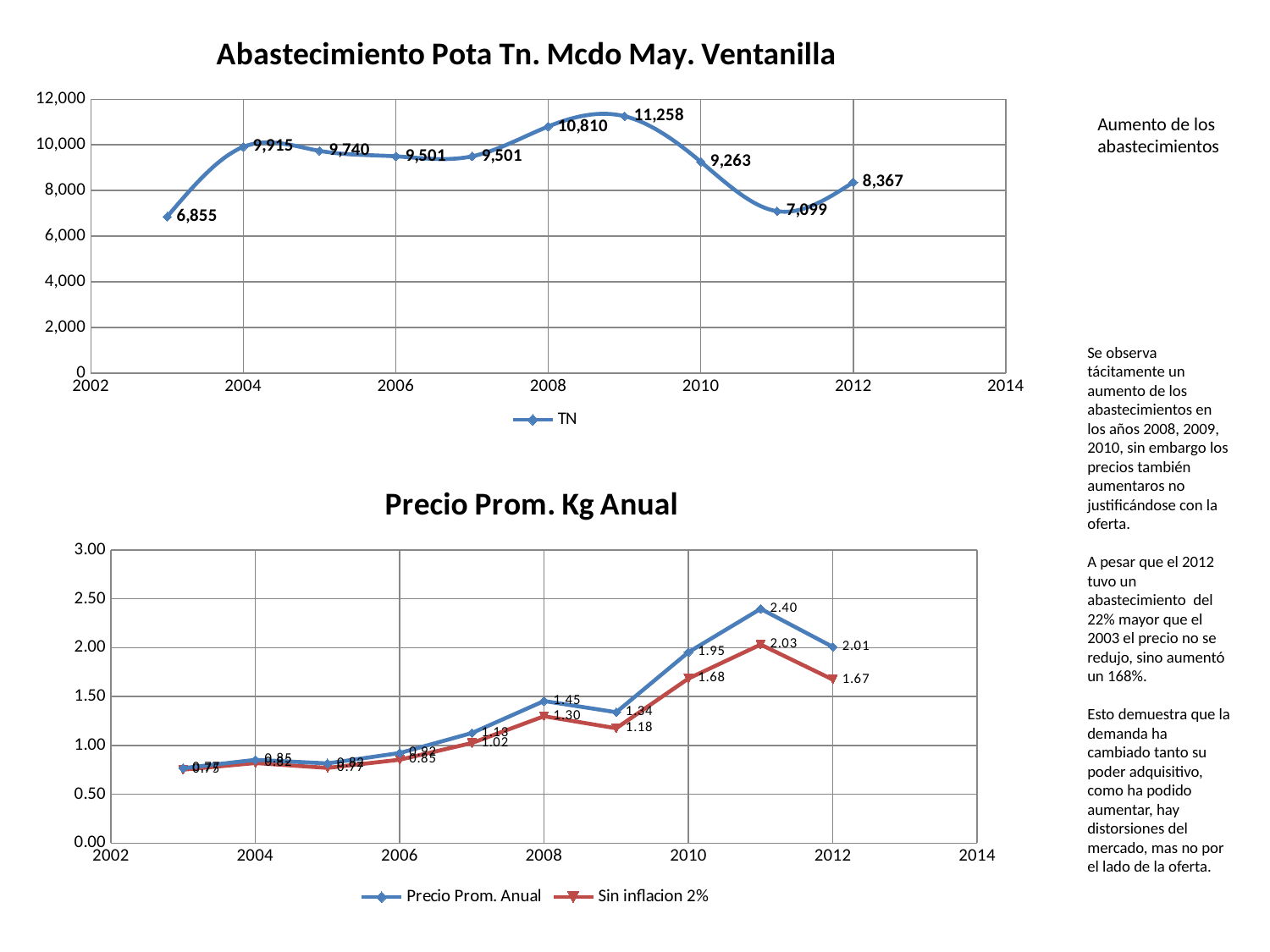
In the chart titled "Abastecimiento Pota Tn. Mcdo May. Ventanilla", what is the difference between the TN values for 2009 and 2011? 4,159 In the chart titled "Abastecimiento Pota Tn. Mcdo May. Ventanilla", how many data points are plotted? 10 What type of chart is the top chart, "Abastecimiento Pota Tn. Mcdo May. Ventanilla"? line chart In the chart titled "Precio Prom. Kg Anual", what is the Sin inflacion 2% value for 2012? 1.67 In the chart titled "Precio Prom. Kg Anual", which is larger in 2010: Precio Prom. Anual or Sin inflacion 2%? Precio Prom. Anual In the chart titled "Abastecimiento Pota Tn. Mcdo May. Ventanilla", which year has the lowest TN value? 2003 In the chart titled "Precio Prom. Kg Anual", how many series does the legend list? 2 In the chart titled "Abastecimiento Pota Tn. Mcdo May. Ventanilla", which year has the highest TN value? 2009 In the chart titled "Precio Prom. Kg Anual", what is the Precio Prom. Anual value for 2011? 2.40 In the chart titled "Abastecimiento Pota Tn. Mcdo May. Ventanilla", is the TN value for 2011 greater or less than 8,000? less In the chart titled "Precio Prom. Kg Anual", what is the difference between Precio Prom. Anual and Sin inflacion 2% in 2011? 0.37 In the chart titled "Abastecimiento Pota Tn. Mcdo May. Ventanilla", what is the TN value for 2009? 11,258